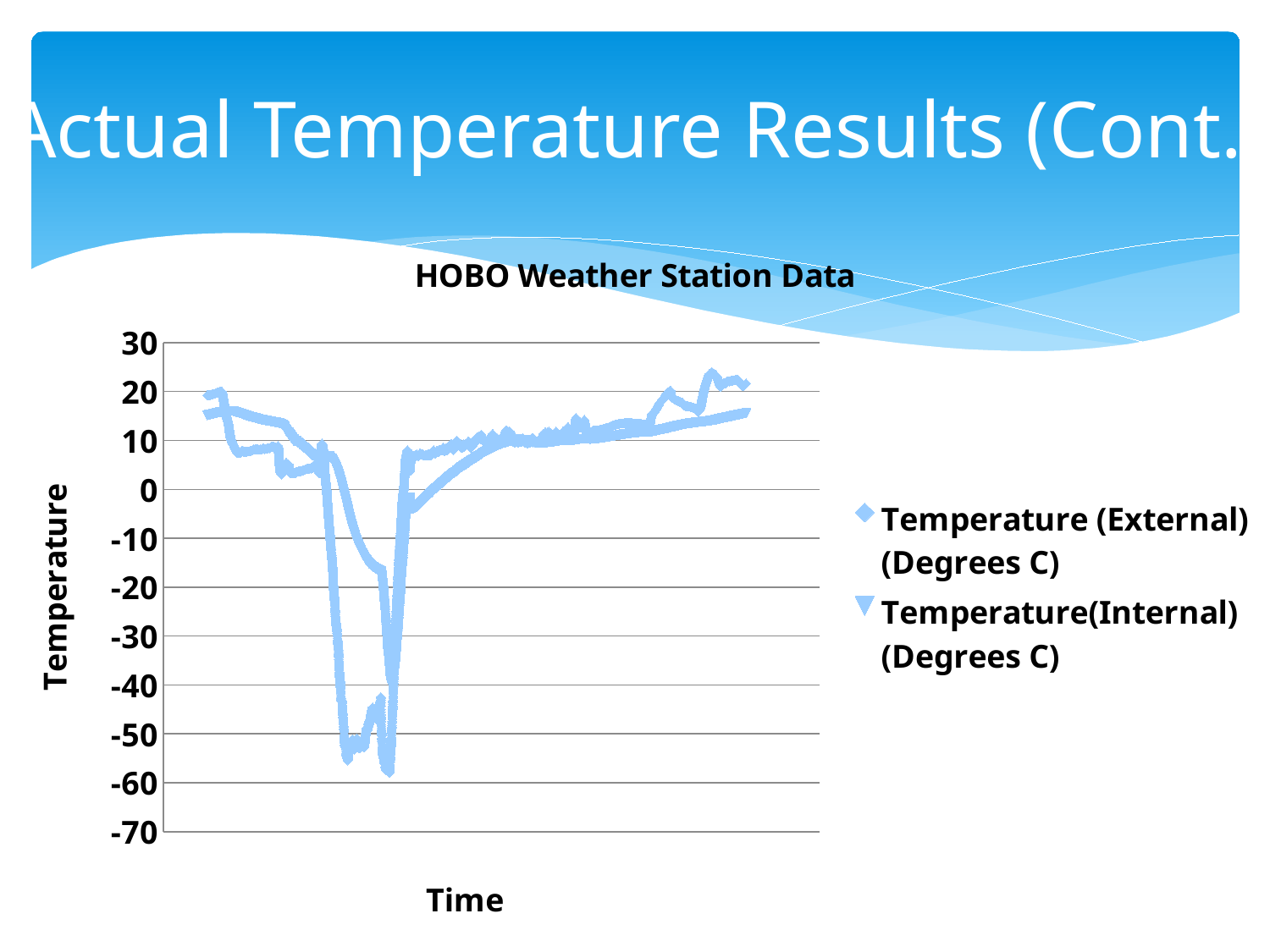
Is the highest temperature plotted on the chart greater or less than 20? greater What is the highest value shown on the vertical axis? 30 What is the lowest value shown on the vertical axis? -70 How many series does the chart legend list? 2 What are the two series named in the legend? Temperature (External) (Degrees C) and Temperature(Internal) (Degrees C) Is the lowest temperature plotted on the chart greater or less than -50? less Do the plotted temperatures rise or fall over the final portion of the time axis, after the sharp dip? rise What is the title of the chart? HOBO Weather Station Data What is the interval between consecutive tick marks on the vertical axis? 10 What is the label of the horizontal axis? Time What is the label of the vertical axis? Temperature